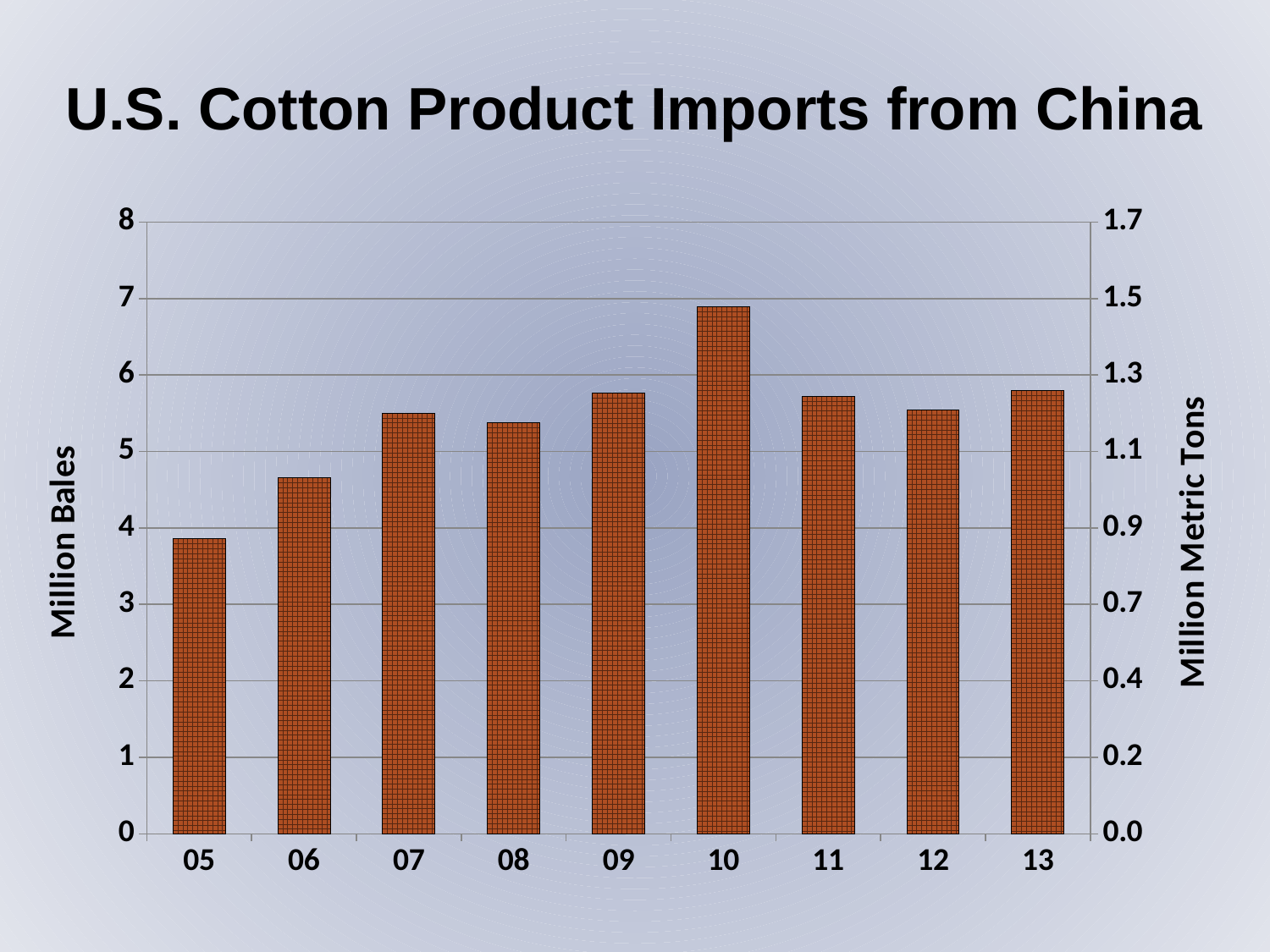
Is the value for 06 greater or less than 5 million bales? less What kind of chart is shown on the slide? bar chart Is the value for 13 greater or less than 5 million bales? greater How many years (bars) are plotted on the chart? 9 Which year has the larger value, 06 or 07? 07 Do the values rise or fall from 05 to 07? rise Which year has the lowest U.S. cotton product imports from China? 05 What is the label of the left vertical axis? Million Bales Is the value for 05 greater or less than 4 million bales? less Which year has the highest U.S. cotton product imports from China? 10 Which year has the larger value, 10 or 13? 10